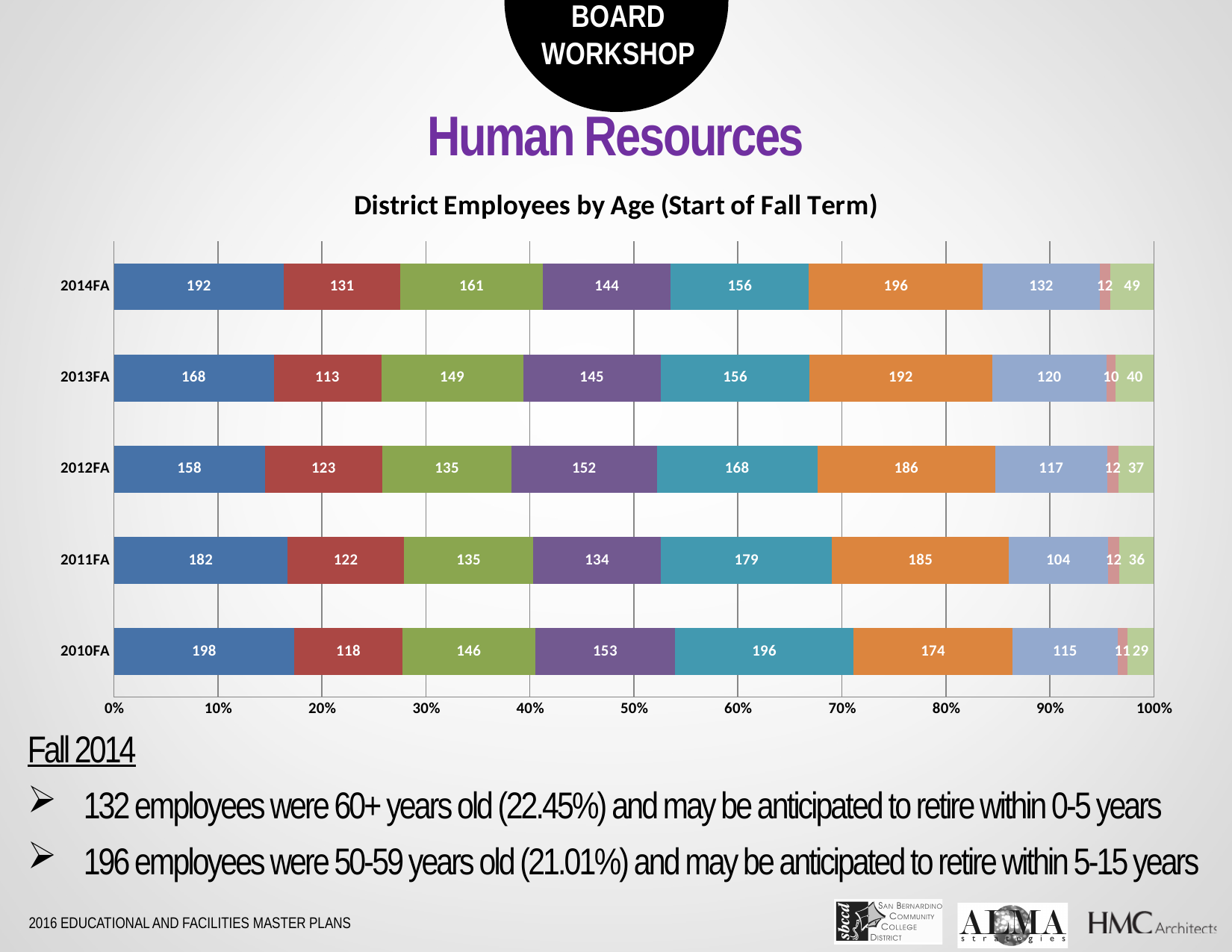
Which fall term has the lowest value in the leftmost (blue) segment? 2012FA How many fall terms (categories) are shown on the y axis of the chart? 5 What kind of chart is shown on the slide? Stacked bar chart Which is larger: the teal segment for 2011FA or the teal segment for 2012FA? 2011FA Which fall term has the highest value in the leftmost (blue) segment? 2010FA What is the total of all segments in the 2014FA bar? 1173 What is the difference between the leftmost (blue) segment values for 2014FA and 2013FA? 24 What is the title of the chart? District Employees by Age (Start of Fall Term) What is the value of the orange segment for 2013FA? 192 What is the value of the leftmost (blue) segment for 2014FA? 192 What is the value of the purple segment for 2012FA? 152 Does the orange segment value rise or fall from 2010FA to 2014FA? Rises